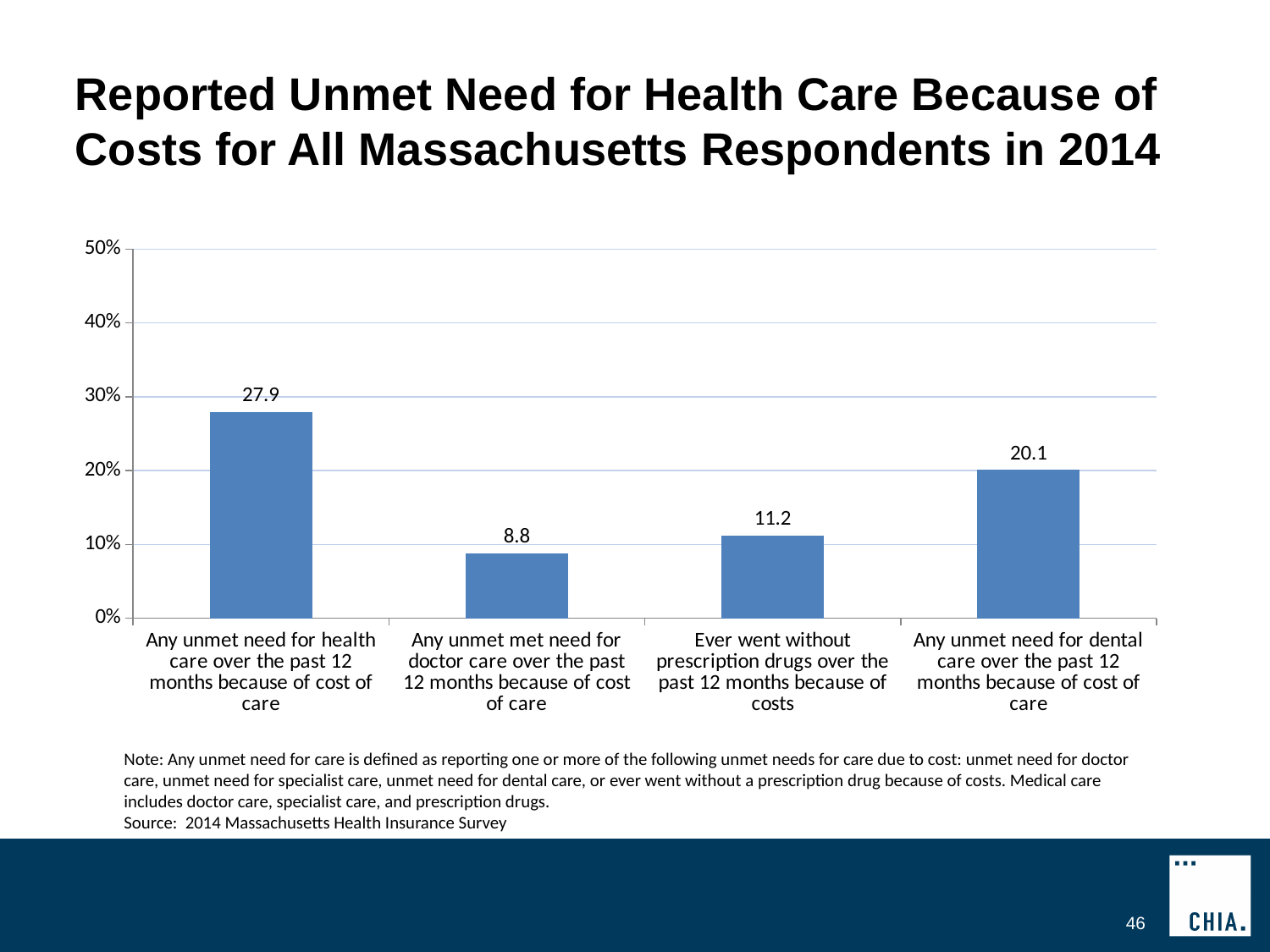
Is the value for any unmet need for dental care greater or less than 30%? less What is the value for 'Any unmet need for health care over the past 12 months because of cost of care'? 27.9 What kind of chart is shown on the slide? bar chart What is the value for 'Any unmet met need for doctor care over the past 12 months because of cost of care'? 8.8 What is the value for 'Ever went without prescription drugs over the past 12 months because of costs'? 11.2 How many categories are shown in the chart? 4 What is the difference between the value for any unmet need for health care and the value for any unmet need for dental care? 7.8 Which is larger: the value for ever went without prescription drugs or the value for any unmet need for doctor care? Ever went without prescription drugs over the past 12 months because of costs What is the source cited for the chart? 2014 Massachusetts Health Insurance Survey Which category has the highest value? Any unmet need for health care over the past 12 months because of cost of care What is the value for 'Any unmet need for dental care over the past 12 months because of cost of care'? 20.1 Which category has the lowest value? Any unmet met need for doctor care over the past 12 months because of cost of care